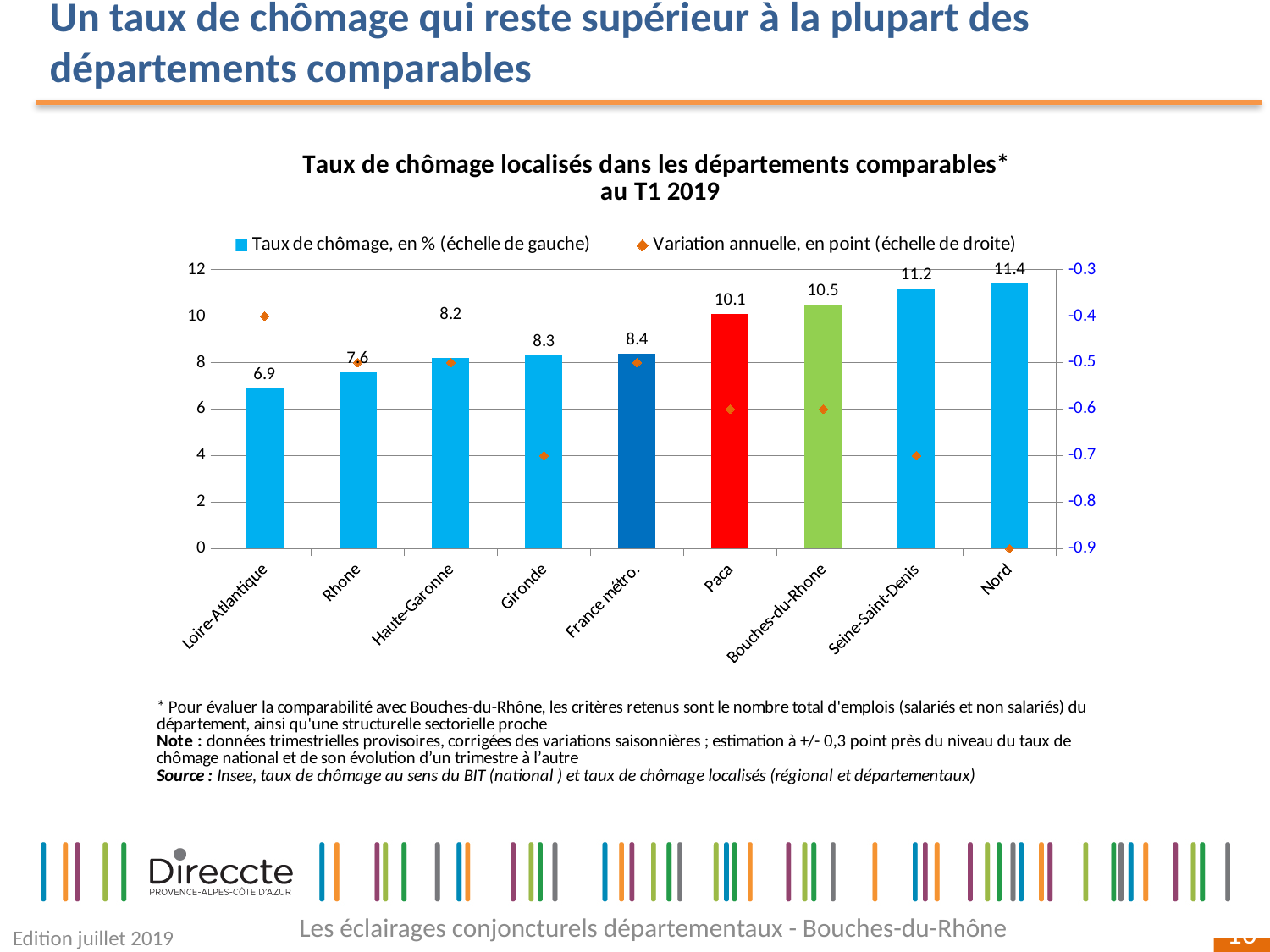
How many series does the legend list? 2 What is the unemployment rate shown for France métro.? 8.4 How many departments or areas are shown on the x axis of the chart? 9 What is the difference in unemployment rate between Bouches-du-Rhone and Paca? 0.4 What is the unemployment rate shown for Loire-Atlantique? 6.9 Which department has the highest unemployment rate on the chart? Nord What is the unemployment rate (Taux de chômage, en %) for Bouches-du-Rhone? 10.5 What is the annual variation in points (Variation annuelle, échelle de droite) for Nord? -0.9 Is the unemployment rate for Rhone greater or less than 8? less What kind of chart is used to show the unemployment rates? Bar chart Which department has the lowest unemployment rate on the chart? Loire-Atlantique Which has a higher unemployment rate, Seine-Saint-Denis or Gironde? Seine-Saint-Denis